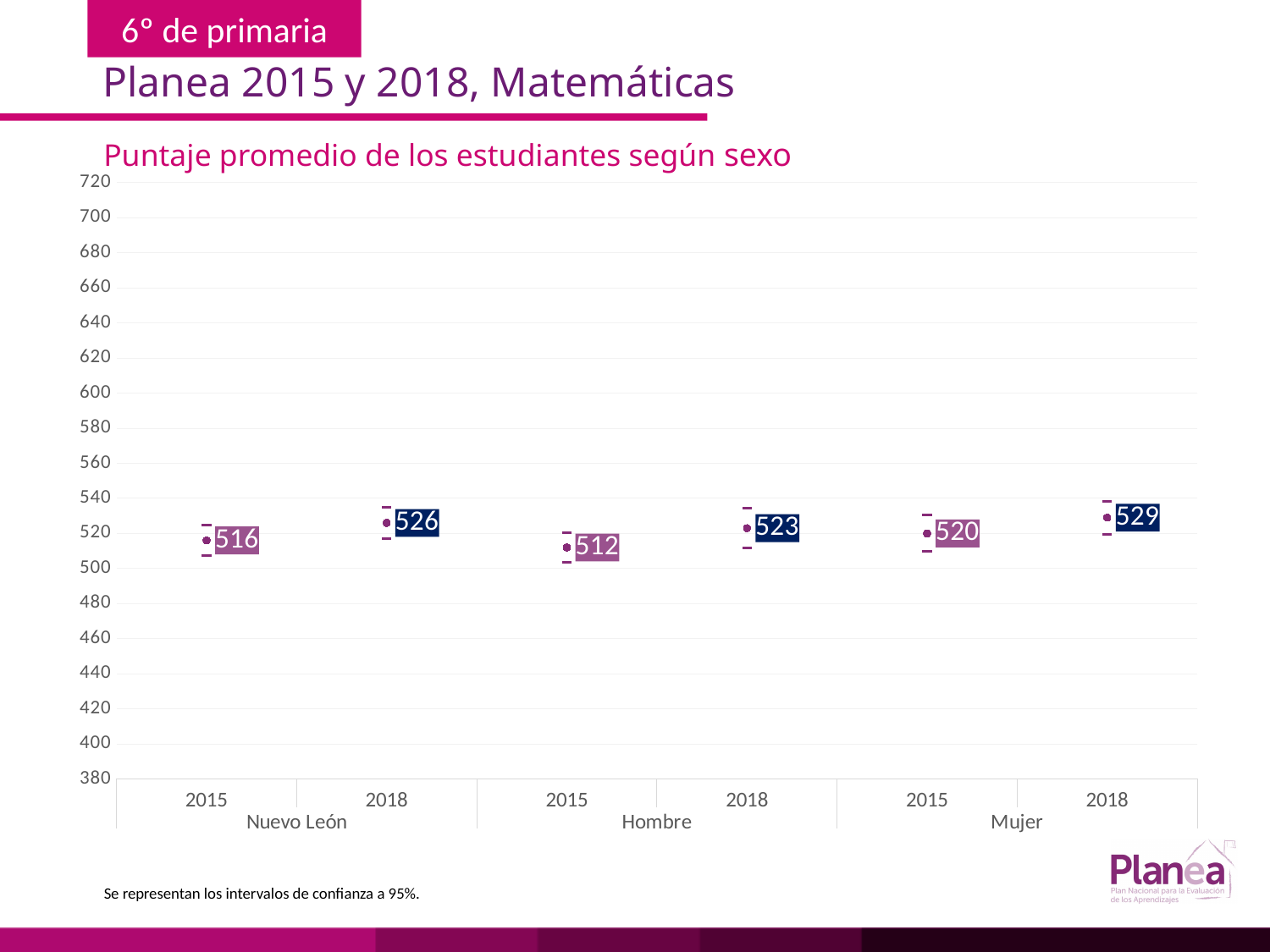
Do the average scores rise or fall from 2015 to 2018 for each group? rise What is the title of the chart? Puntaje promedio de los estudiantes según sexo Which group and year has the highest average score? Mujer 2018 How many data points are plotted on the chart? 6 By how many points did the Nuevo León average score change from 2015 to 2018? 10 Which group and year has the lowest average score? Hombre 2015 Which is larger, the Hombre 2015 score or the Mujer 2015 score? Mujer 2015 What is the difference between the Mujer and Hombre average scores in 2018? 6 What is the average score for Nuevo León in 2015? 516 What is the average score for Mujer in 2018? 529 Is the Hombre 2018 average score greater or less than 540? less What is the average score for Hombre in 2018? 523